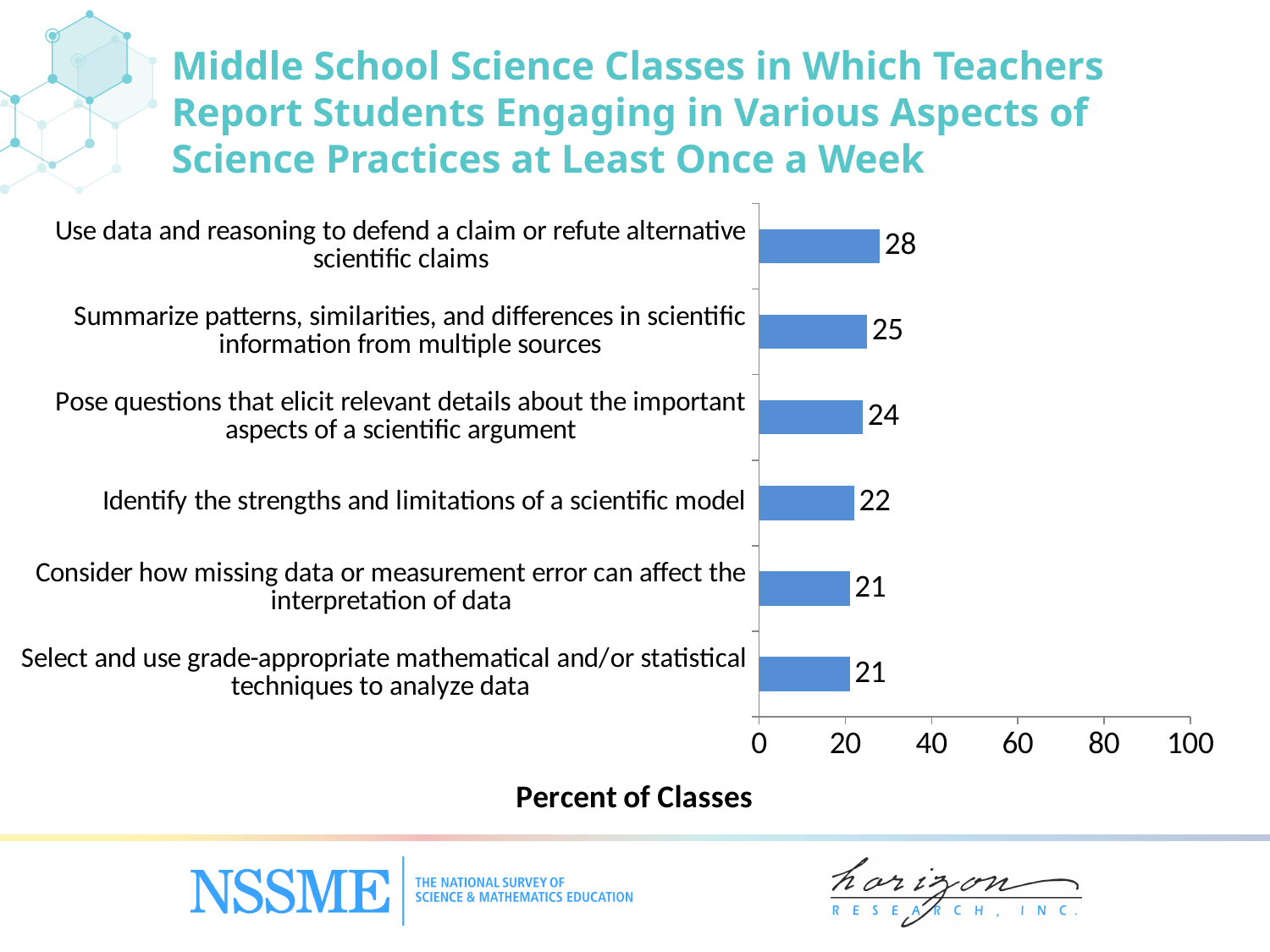
What percent of classes is reported for "Use data and reasoning to defend a claim or refute alternative scientific claims"? 28 What is the difference between the values for "Use data and reasoning to defend a claim or refute alternative scientific claims" and "Summarize patterns, similarities, and differences in scientific information from multiple sources"? 3 Which is larger: the value for "Summarize patterns, similarities, and differences in scientific information from multiple sources" or for "Identify the strengths and limitations of a scientific model"? Summarize patterns, similarities, and differences in scientific information from multiple sources What is the value for "Identify the strengths and limitations of a scientific model"? 22 Is the value for "Consider how missing data or measurement error can affect the interpretation of data" greater or less than 40? less Which aspect of science practices has the highest percent of classes? Use data and reasoning to defend a claim or refute alternative scientific claims What is the label of the horizontal axis? Percent of Classes What is the value for "Pose questions that elicit relevant details about the important aspects of a scientific argument"? 24 What kind of chart is shown on the slide? bar chart What is the lowest value shown on the chart? 21 What is the maximum value shown on the horizontal axis? 100 How many categories are shown on the chart? 6